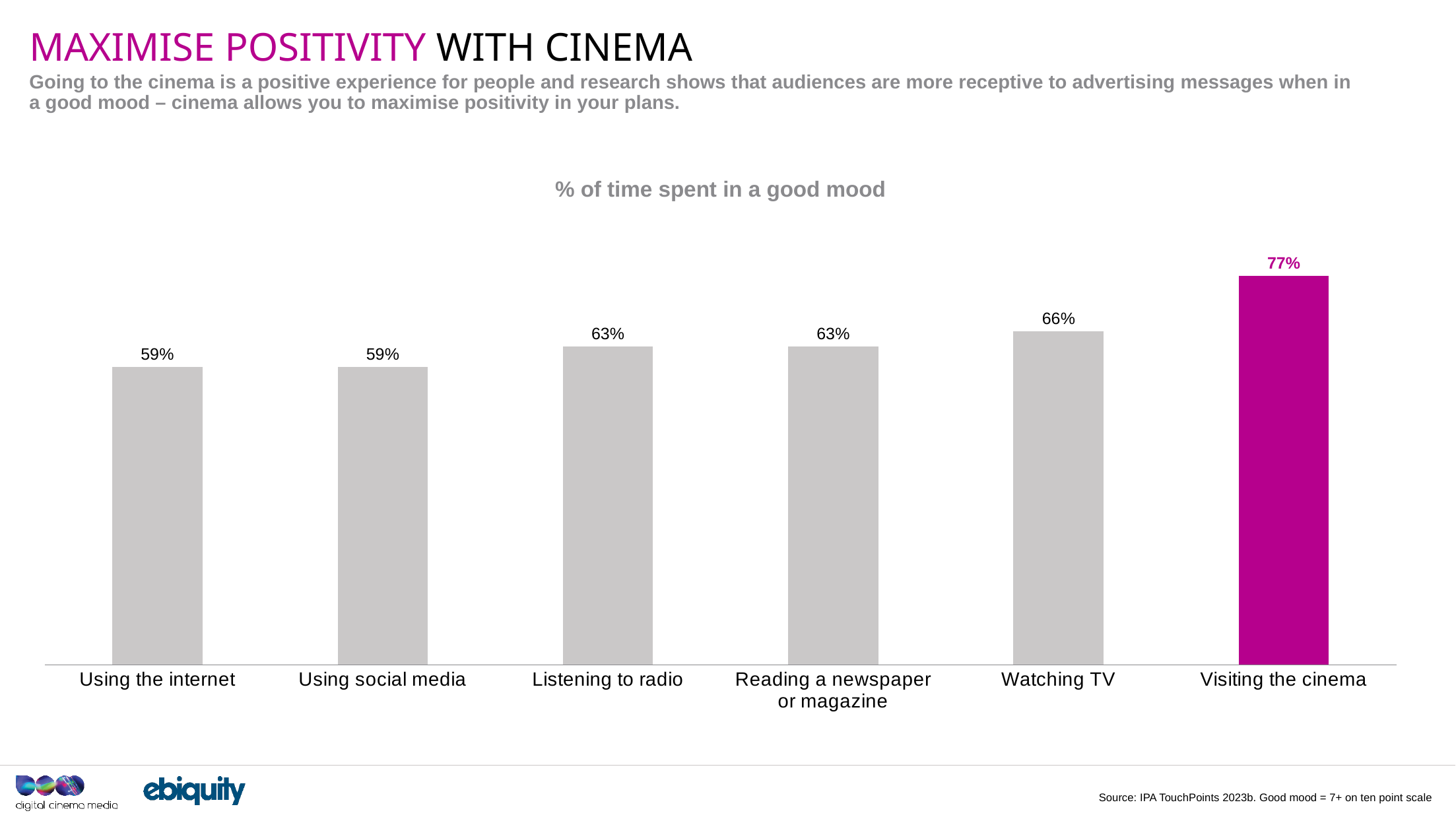
What is the value for Visiting the cinema? 77% Which is larger, the value for Watching TV or the value for Listening to radio? Watching TV What is the difference between the values for Watching TV and Using the internet? 7% What kind of chart is shown on the slide? Bar chart What is the value for Using social media? 59% How many categories are shown in the chart? 6 What is the value for Listening to radio? 63% What is the value for Watching TV? 66% What is the title of the chart? % of time spent in a good mood Which category has the highest value? Visiting the cinema What is the difference between the values for Visiting the cinema and Watching TV? 11% Do the values rise or fall from left to right across the categories? Rise